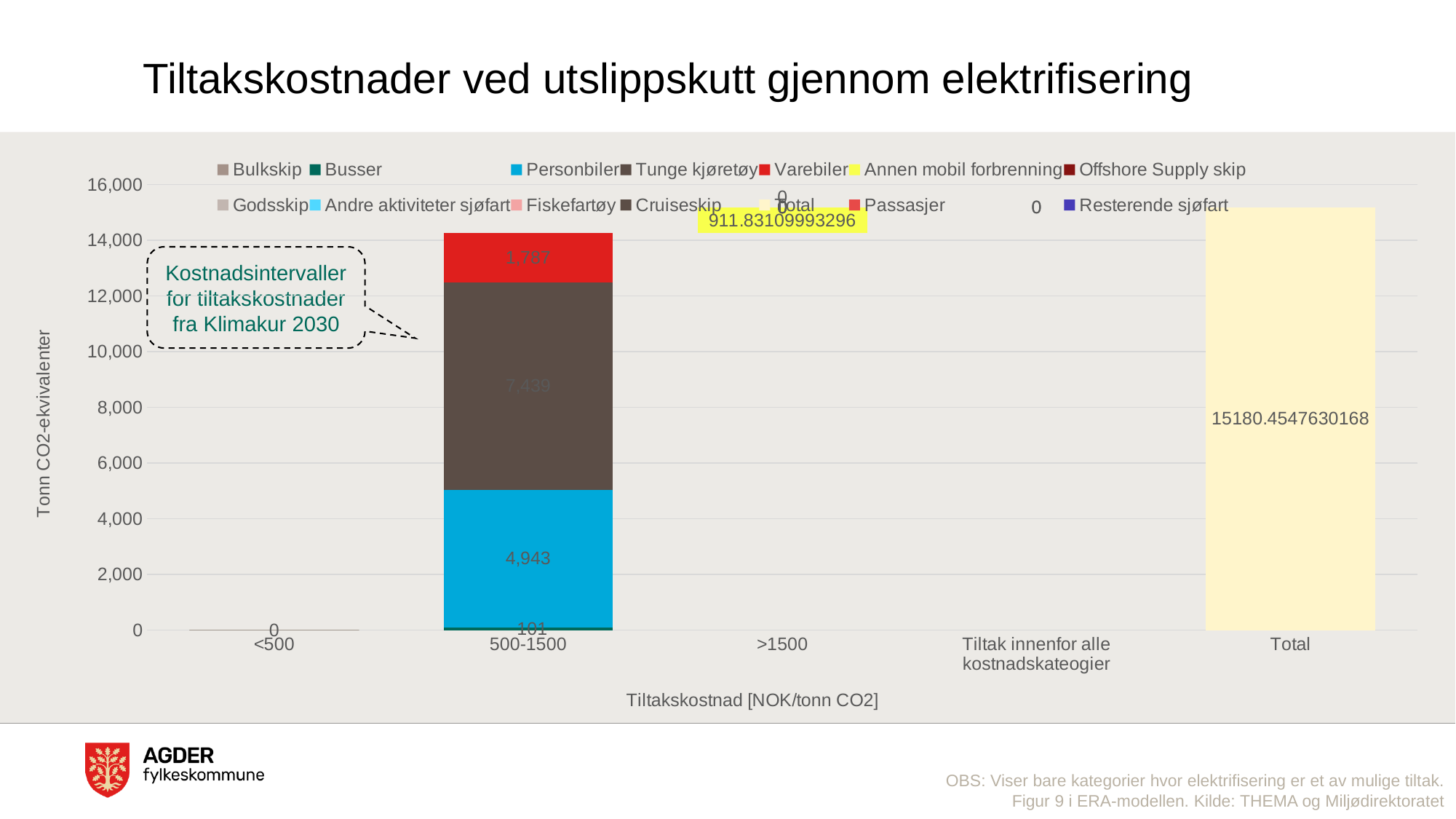
What value is labelled on the Total bar? 15180.4547630168 Is the value of the Total bar greater or less than 14,000? greater How many series does the legend list? 14 What kind of chart is shown on the slide? Stacked bar chart What is the value for Varebiler in the 500-1500 cost category? 1,787 What is the difference between the Tunge kjøretøy value and the Personbiler value in the 500-1500 category? 2,496 How many cost categories are shown on the x axis? 5 In the 500-1500 category, which is larger: Personbiler or Varebiler? Personbiler What is the value for Tunge kjøretøy in the 500-1500 cost category? 7,439 What value is labelled on the bar in the >1500 cost category? 911.83109993296 What is the value for Personbiler in the 500-1500 cost category? 4,943 Which cost category has the tallest bar? Total